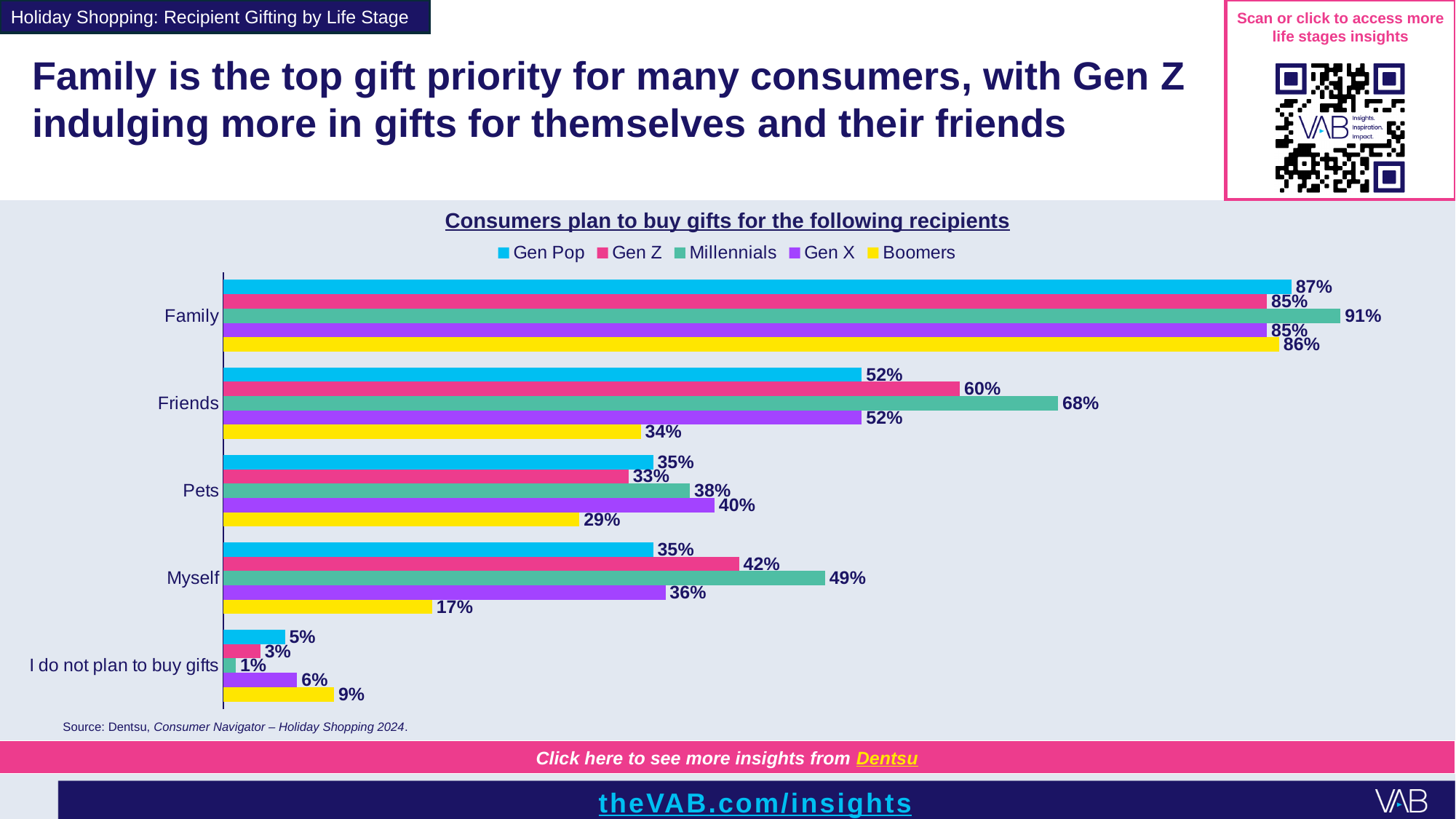
Which generation has the lowest value for Myself? Boomers What percentage of Gen Z plan to buy gifts for Myself? 42% What is the difference between the Millennials and Gen Pop values for Myself? 14% What is the title of the chart? Consumers plan to buy gifts for the following recipients Which colour represents Boomers in the chart? Yellow How many series does the legend list? 5 Which generation has the highest value for Friends? Millennials Which is larger for Pets: the Gen X value or the Gen Z value? Gen X How many recipient categories are shown on the chart? 5 What percentage of Boomers plan to buy gifts for Friends? 34% What percentage of Millennials plan to buy gifts for Family? 91% What kind of chart is shown on the slide? Bar chart